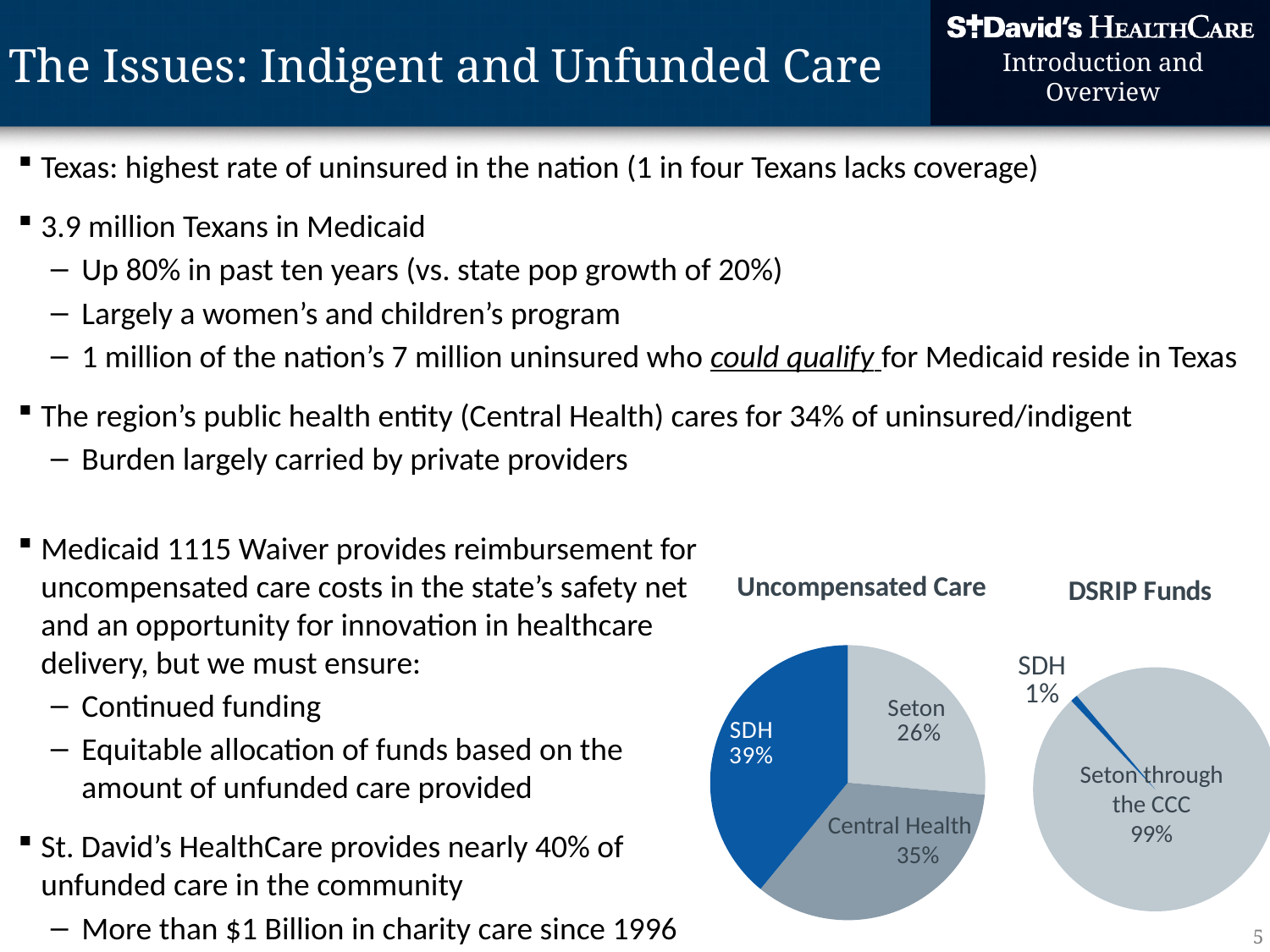
In the Uncompensated Care chart, which category has the largest share? SDH In the DSRIP Funds chart, what share does SDH have? 1% How many slices does the Uncompensated Care chart have? 3 In the Uncompensated Care chart, what share does Seton have? 26% In the Uncompensated Care chart, what share does SDH have? 39% What type of chart is the DSRIP Funds chart? Pie chart In the Uncompensated Care chart, which category has the smallest share? Seton In the Uncompensated Care chart, what share does Central Health have? 35% How many slices does the DSRIP Funds chart have? 2 In the DSRIP Funds chart, what share does Seton through the CCC have? 99% In the Uncompensated Care chart, which is larger, Central Health or Seton? Central Health In the Uncompensated Care chart, what is the difference between the SDH share and the Seton share? 13%